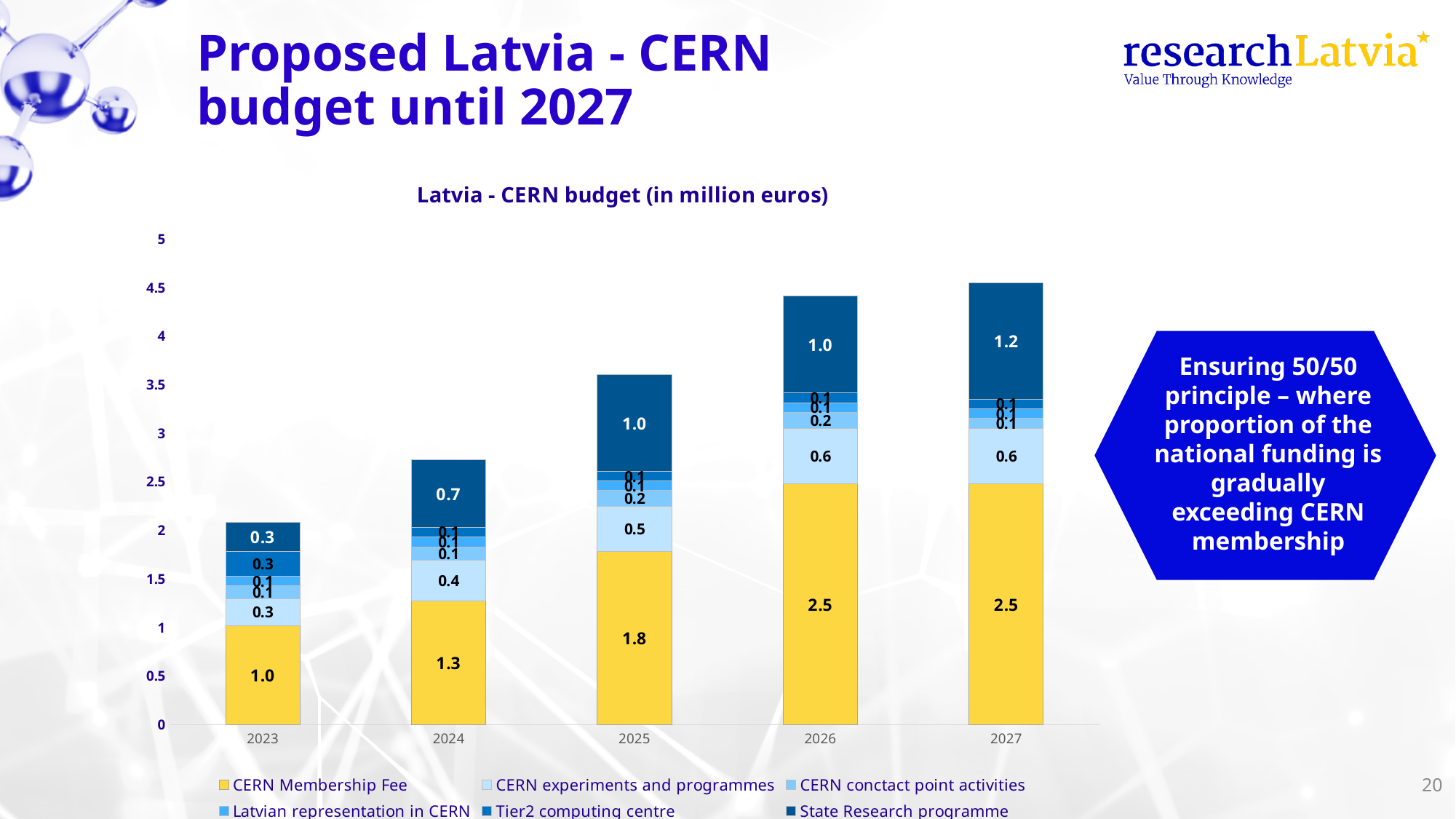
Which year has the highest total budget bar? 2027 Is the total bar for 2026 greater or less than 4? greater What is the CERN Membership Fee value for 2025? 1.8 Does the CERN Membership Fee rise or fall from 2023 to 2027? rise How many series does the legend list? 6 What is the value for CERN experiments and programmes in 2026? 0.6 What kind of chart is shown on the slide? stacked bar chart How many years are shown on the x axis? 5 Which year has the lowest total budget bar? 2023 What is the State Research programme value for 2027? 1.2 Which year has the larger State Research programme value, 2024 or 2025? 2025 What is the difference between the CERN Membership Fee in 2027 and in 2023? 1.5